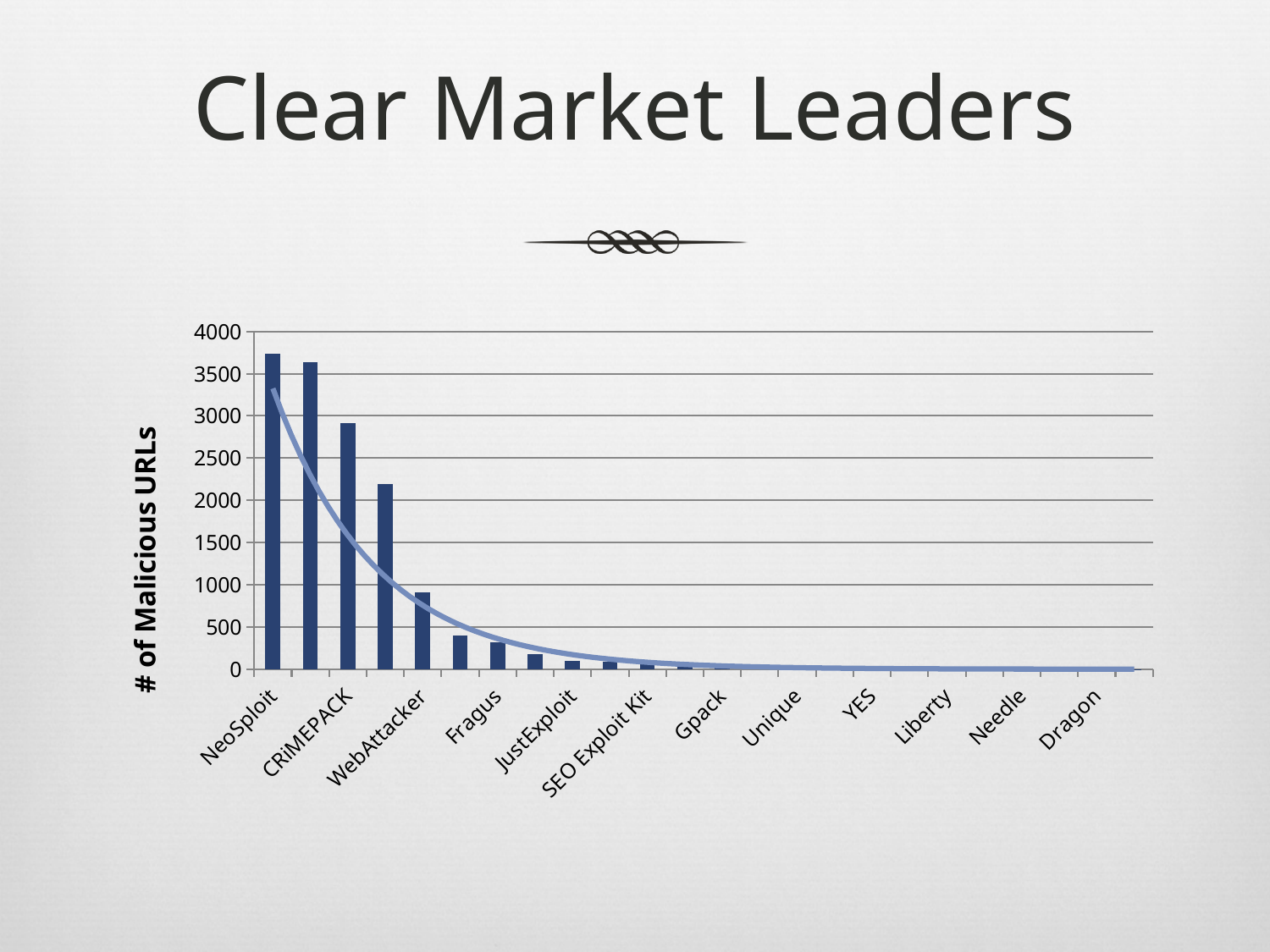
Is the value for NeoSploit greater or less than 3500? greater Is the value for Fragus greater or less than 500? less Do the values rise or fall moving from left to right along the x axis? fall What kind of chart is shown on the slide? bar chart Is the value for CRiMEPACK greater or less than 3000? less Which has more malicious URLs, Fragus or NeoSploit? NeoSploit Which has more malicious URLs, CRiMEPACK or WebAttacker? CRiMEPACK Which category has the highest number of malicious URLs? NeoSploit What is the label on the vertical axis of the chart? # of Malicious URLs What is the title of the slide containing the chart? Clear Market Leaders